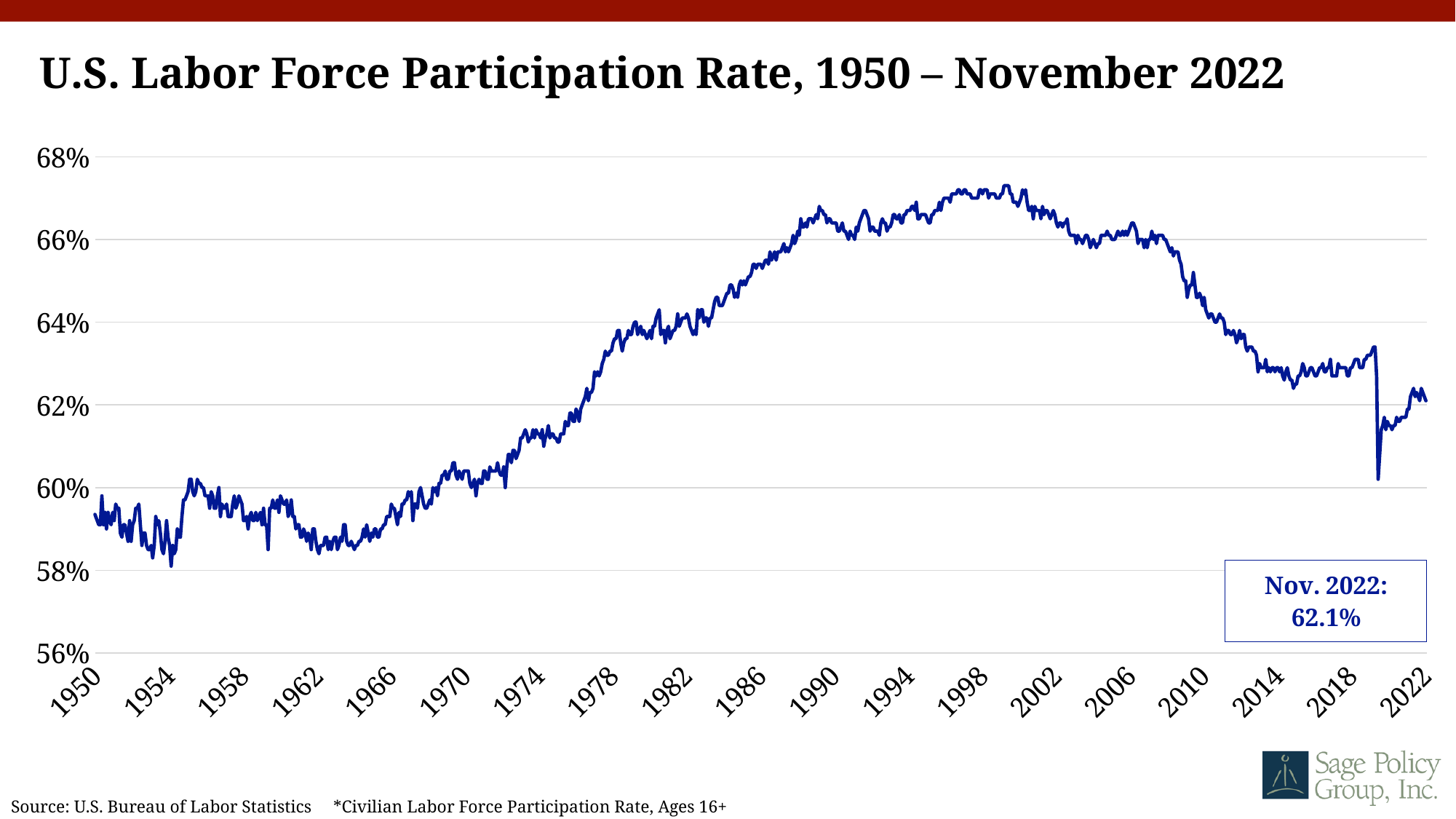
Is the labor force participation rate in 1962 greater or less than 60%? less Does the labor force participation rate generally rise or fall between 2002 and 2014? fall What source is cited for the chart data? U.S. Bureau of Labor Statistics Is the labor force participation rate in 1998 greater or less than 66%? greater Does the labor force participation rate generally rise or fall between 1966 and 1990? rise What kind of chart is shown on the slide? Line chart What is the labor force participation rate for November 2022 shown in the callout box? 62.1% What is the title of the chart? U.S. Labor Force Participation Rate, 1950 – November 2022 Is the labor force participation rate in 2014 greater or less than 64%? less Is the labor force participation rate higher in 1990 or in 2018? 1990